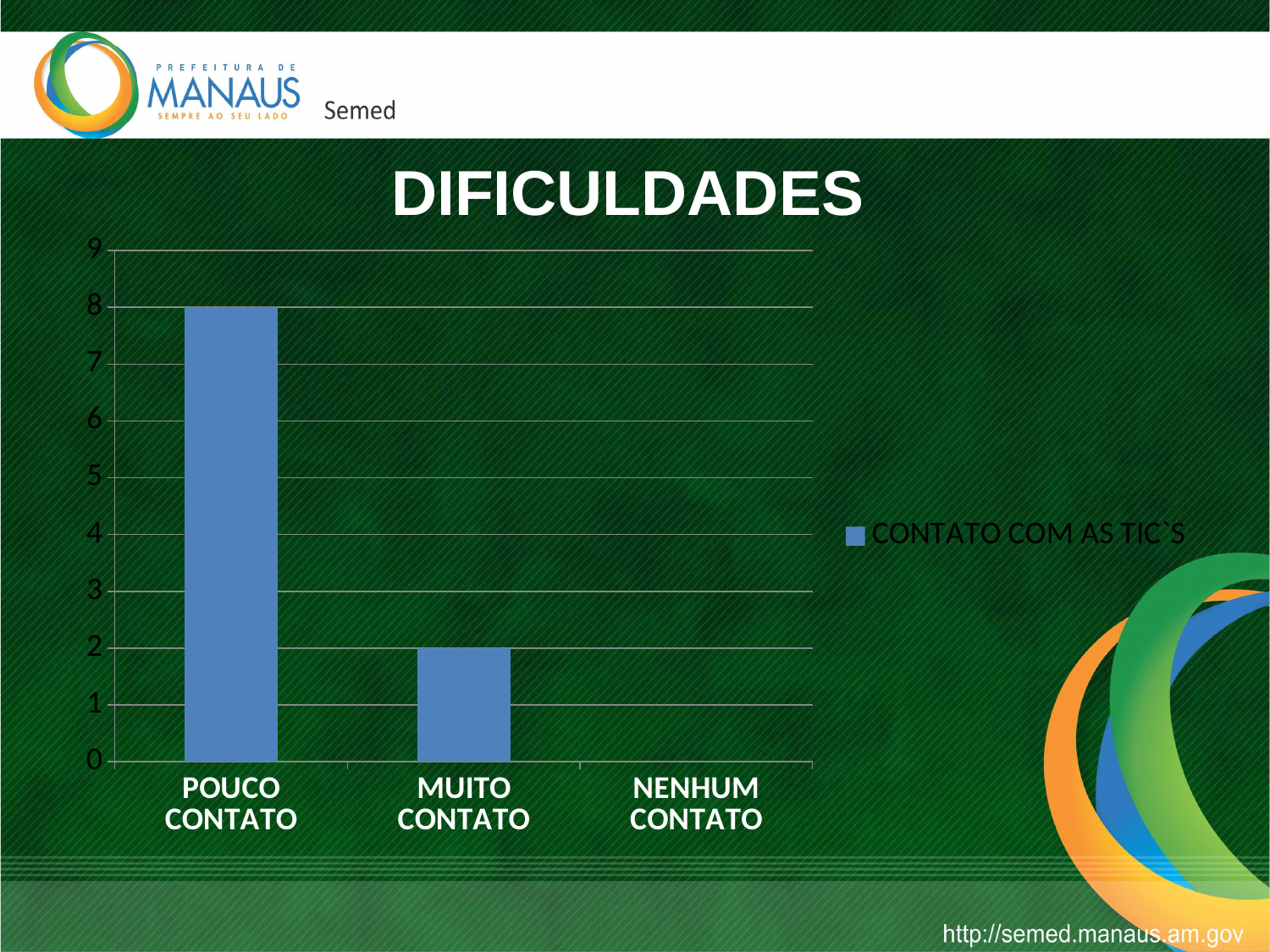
How many series does the legend list? 1 Which is larger, the value for POUCO CONTATO or the value for MUITO CONTATO? POUCO CONTATO Is the value for POUCO CONTATO greater or less than 5? greater What is the value for POUCO CONTATO? 8 What is the value for MUITO CONTATO? 2 What is the title of the chart? DIFICULDADES Which category has the lowest value? NENHUM CONTATO How many categories are shown on the x axis? 3 What is the difference between the values for POUCO CONTATO and MUITO CONTATO? 6 Which category has the highest value? POUCO CONTATO What is the value for NENHUM CONTATO? 0 What type of chart is shown on the slide? bar chart